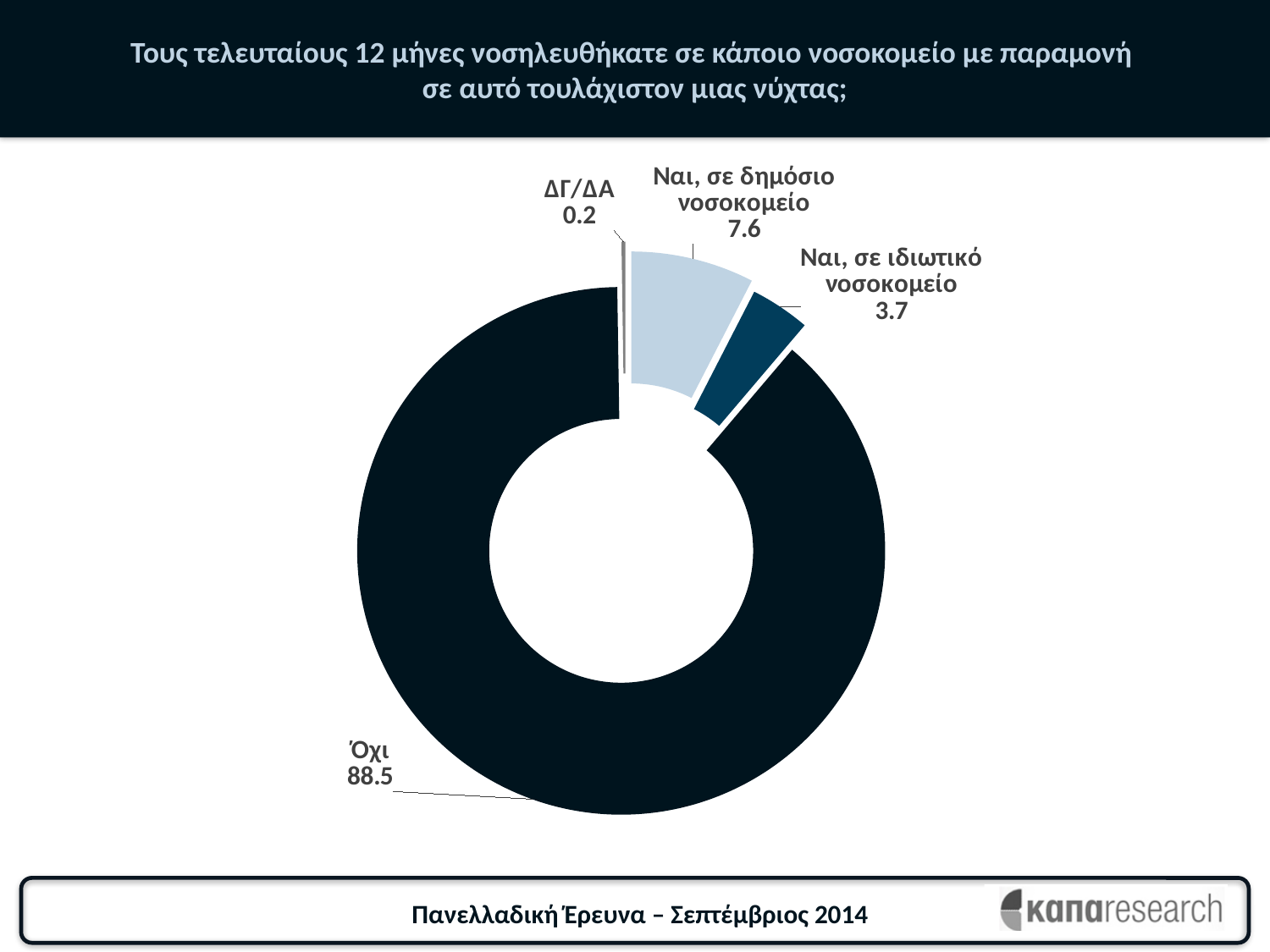
What kind of chart is shown on the slide? doughnut chart Which category has the largest value? Όχι Which category has the smallest value? ΔΓ/ΔΑ What is the value for Όχι? 88.5 What is the combined value of the two 'Ναι' categories? 11.3 What is the value for Ναι, σε δημόσιο νοσοκομείο? 7.6 Which is larger, the value for Ναι, σε δημόσιο νοσοκομείο or the value for Ναι, σε ιδιωτικό νοσοκομείο? Ναι, σε δημόσιο νοσοκομείο What is the difference between the values for Ναι, σε δημόσιο νοσοκομείο and Ναι, σε ιδιωτικό νοσοκομείο? 3.9 How many categories are shown in the chart? 4 What is the value for ΔΓ/ΔΑ? 0.2 What colour is the Όχι segment of the chart? black What is the value for Ναι, σε ιδιωτικό νοσοκομείο? 3.7